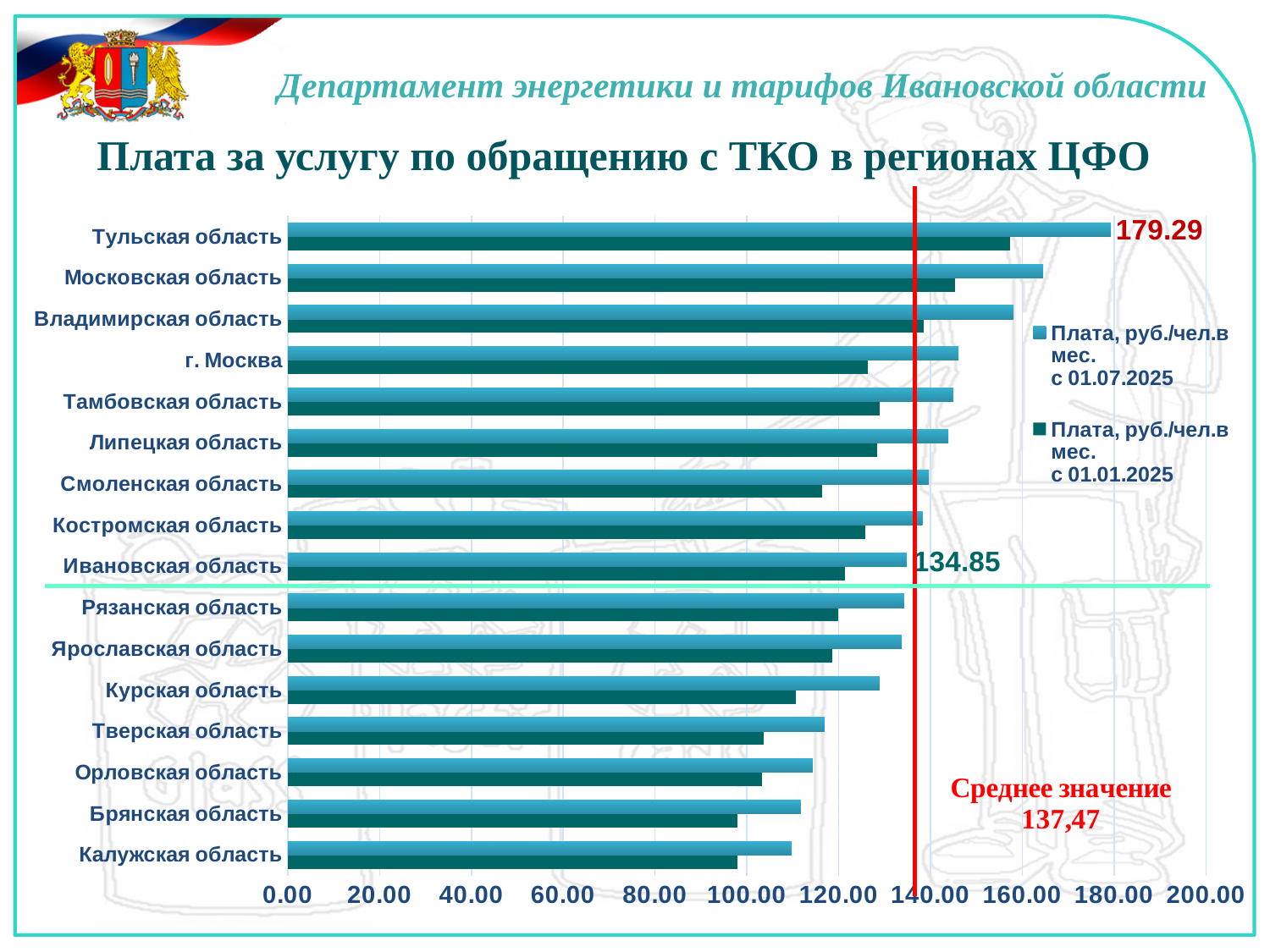
Is the value for Московская область in the 'с 01.07.2025' series greater or less than 160.00? greater In the 'с 01.07.2025' series, which is larger: Владимирская область or г. Москва? Владимирская область Is the value for Калужская область in the 'с 01.07.2025' series greater or less than 120.00? less How many series does the legend list? 2 What average value (Среднее значение) is marked on the chart? 137,47 What is the difference between the labelled values for Тульская область and Ивановская область in the 'с 01.07.2025' series? 44.44 How many regions are listed on the chart? 16 What kind of chart is shown on the slide? bar chart What is the value for Тульская область in the series 'Плата, руб./чел.в мес. с 01.07.2025'? 179.29 Do the values in the 'с 01.07.2025' series rise or fall going from the top region to the bottom region? fall Which region has the highest value in the series 'Плата, руб./чел.в мес. с 01.07.2025'? Тульская область What is the value for Ивановская область in the series 'Плата, руб./чел.в мес. с 01.07.2025'? 134.85